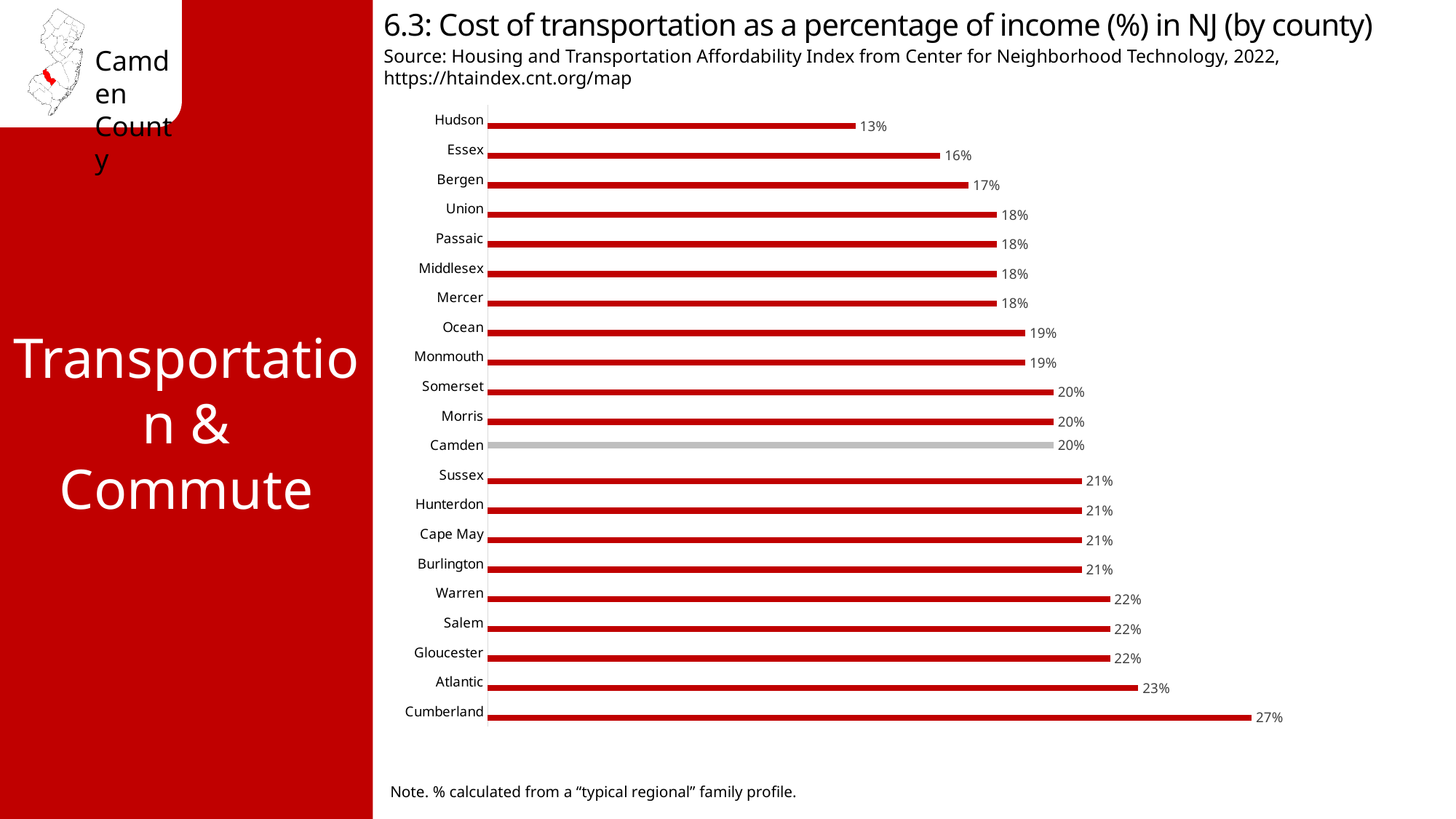
What type of chart is shown on the slide? Bar chart Which county's bar is shown in grey rather than red? Camden What is the cost of transportation as a percentage of income for Camden County? 20% What is the value shown for Atlantic County? 23% Which has a higher value, Bergen or Gloucester? Gloucester What is the value shown for Hudson County? 13% What is the difference between the values for Camden and Essex? 4% What is the source of the data shown in the chart? Housing and Transportation Affordability Index from Center for Neighborhood Technology, 2022 What is the difference between the values for Cumberland and Hudson? 14% Which county has the lowest cost of transportation as a percentage of income? Hudson Which county has the highest cost of transportation as a percentage of income? Cumberland How many counties are shown in the chart? 21